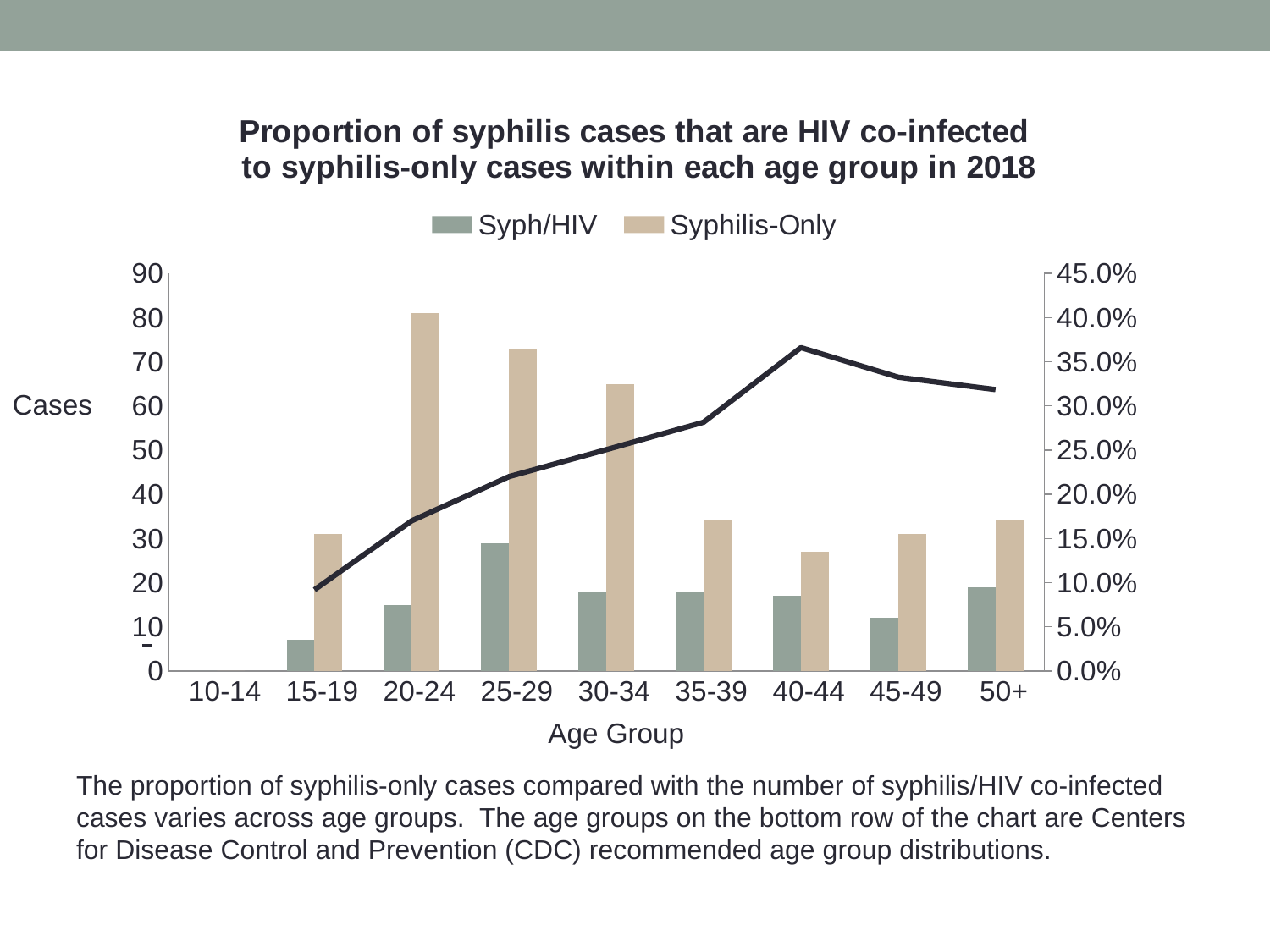
How many age groups are shown on the x axis? 9 Is the Syphilis-Only value for 20-24 greater or less than 70? greater Does the line rise or fall from the 15-19 age group to the 40-44 age group? rises Which is larger, the Syph/HIV value for 45-49 or for 50+? 50+ Which age group has the highest Syphilis-Only bar? 20-24 What is the label on the x axis of the chart? Age Group Is the Syphilis-Only value for 40-44 greater or less than 30? less Which age group has the highest Syph/HIV bar? 25-29 Which is larger, the Syphilis-Only value for 30-34 or for 35-39? 30-34 What kind of chart is shown on the slide? A bar chart with a line overlay Is the Syph/HIV value for 15-19 greater or less than 10? less How many series does the legend list? 2